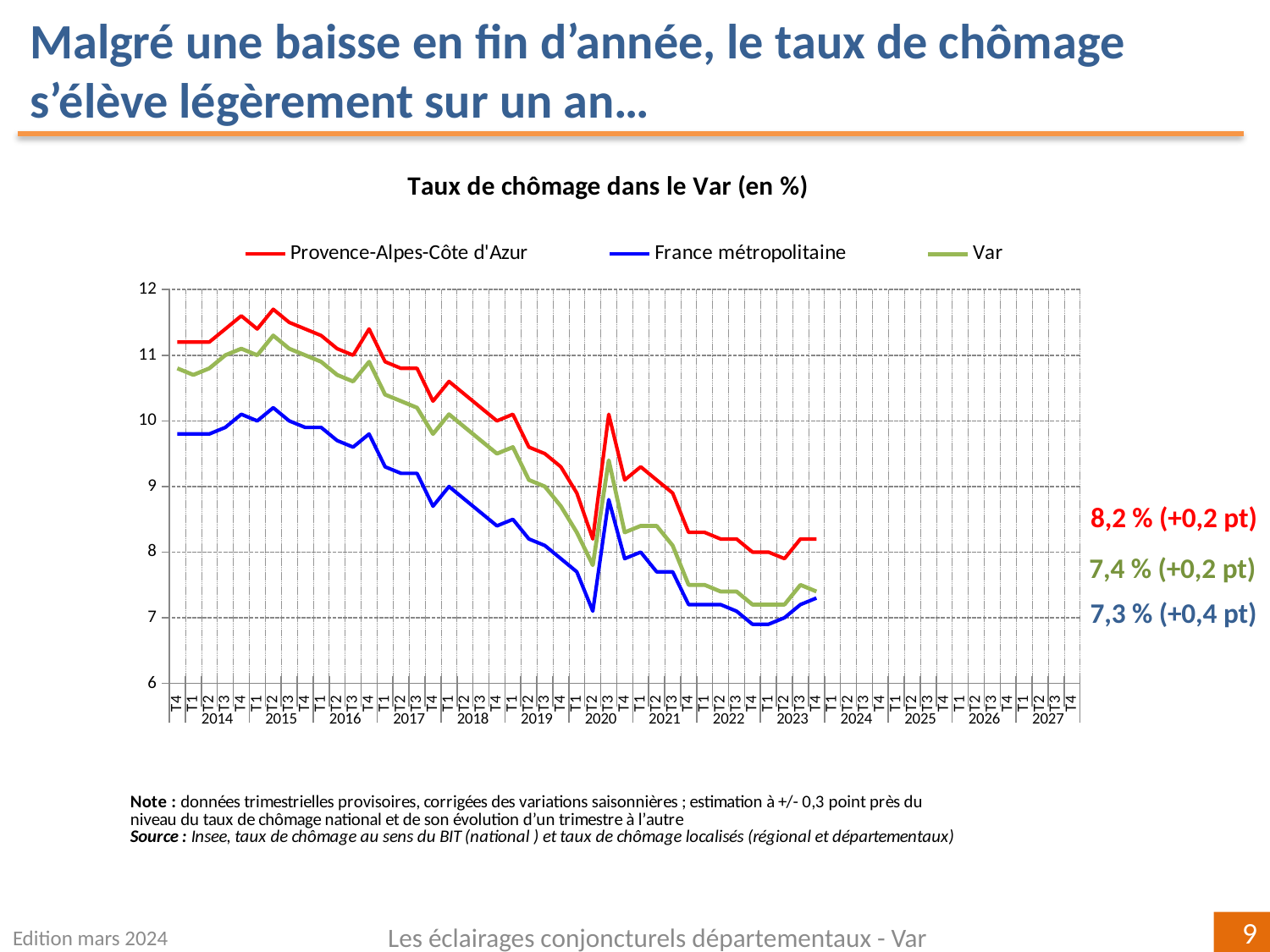
What is the latest value shown for Provence-Alpes-Côte d'Azur? 8,2 % Is the value for Provence-Alpes-Côte d'Azur at T2 2015 greater or less than 11? greater What is the latest value shown for Var? 7,4 % How many series does the legend list? 3 What is the title of the chart? Taux de chômage dans le Var (en %) What is the difference between the latest values for Provence-Alpes-Côte d'Azur and Var? 0,8 pt What kind of chart is shown on the slide? line chart What is the latest value shown for France métropolitaine? 7,3 % Which series has the highest latest value? Provence-Alpes-Côte d'Azur Overall, do the unemployment rates rise or fall from 2014 to 2023? fall Which colour is used for the Var series? green Which series has the lowest latest value? France métropolitaine